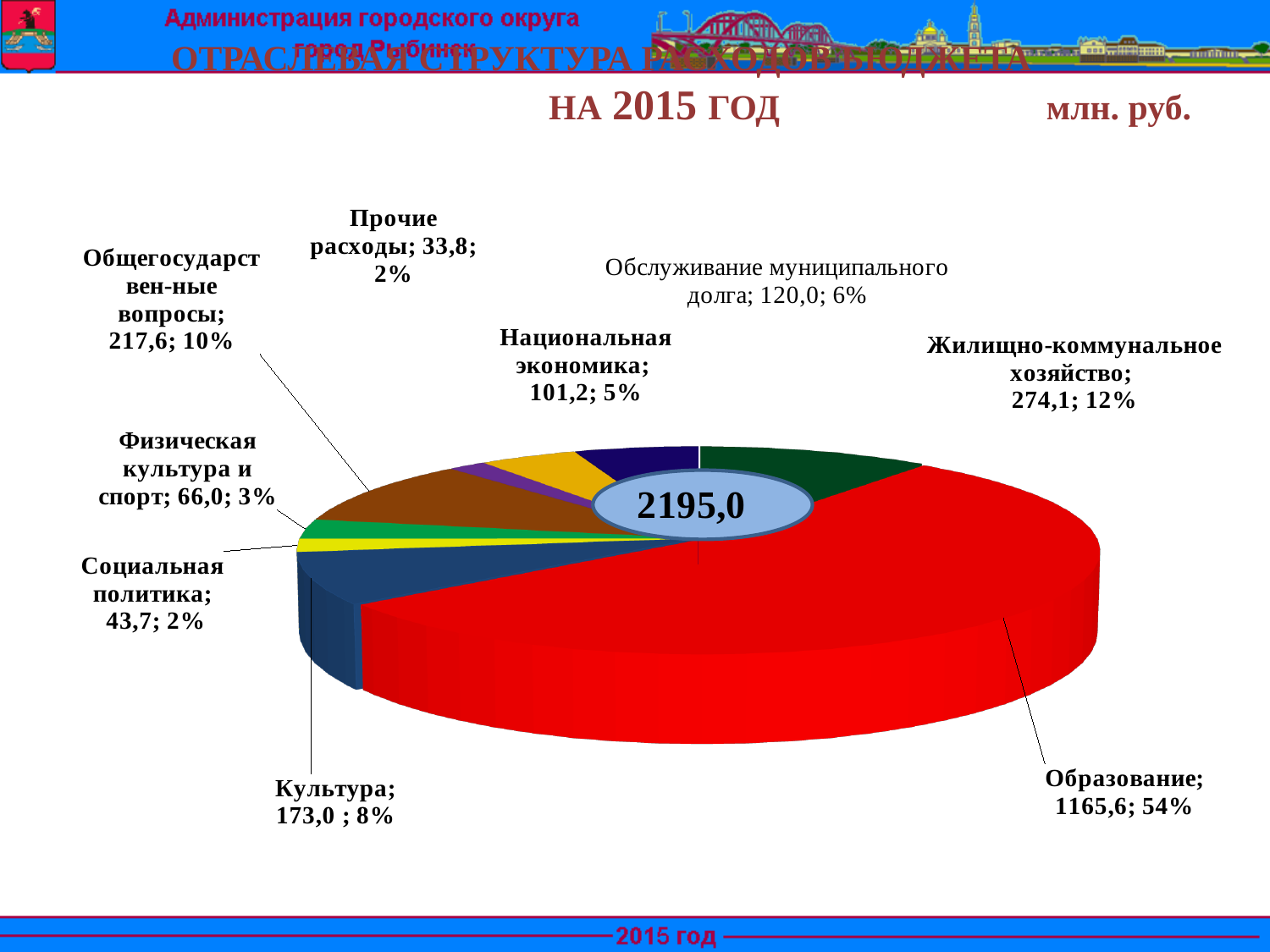
What is the value for Жилищно-коммунальное хозяйство? 274,1 What is the value for Образование? 1165,6 What kind of chart is shown on the slide? pie chart What total value is shown in the centre of the pie chart? 2195,0 Which category has the smallest value? Прочие расходы Which is larger, the value for Физическая культура и спорт or the value for Социальная политика? Физическая культура и спорт What share of the pie does Общегосударственные вопросы represent? 10% What is the difference between the values for Общегосударственные вопросы and Национальная экономика? 116,4 How many categories (slices) does the pie chart show? 9 What is the value for Культура? 173,0 What share of the pie does Обслуживание муниципального долга represent? 6% Which category has the largest share of the pie? Образование